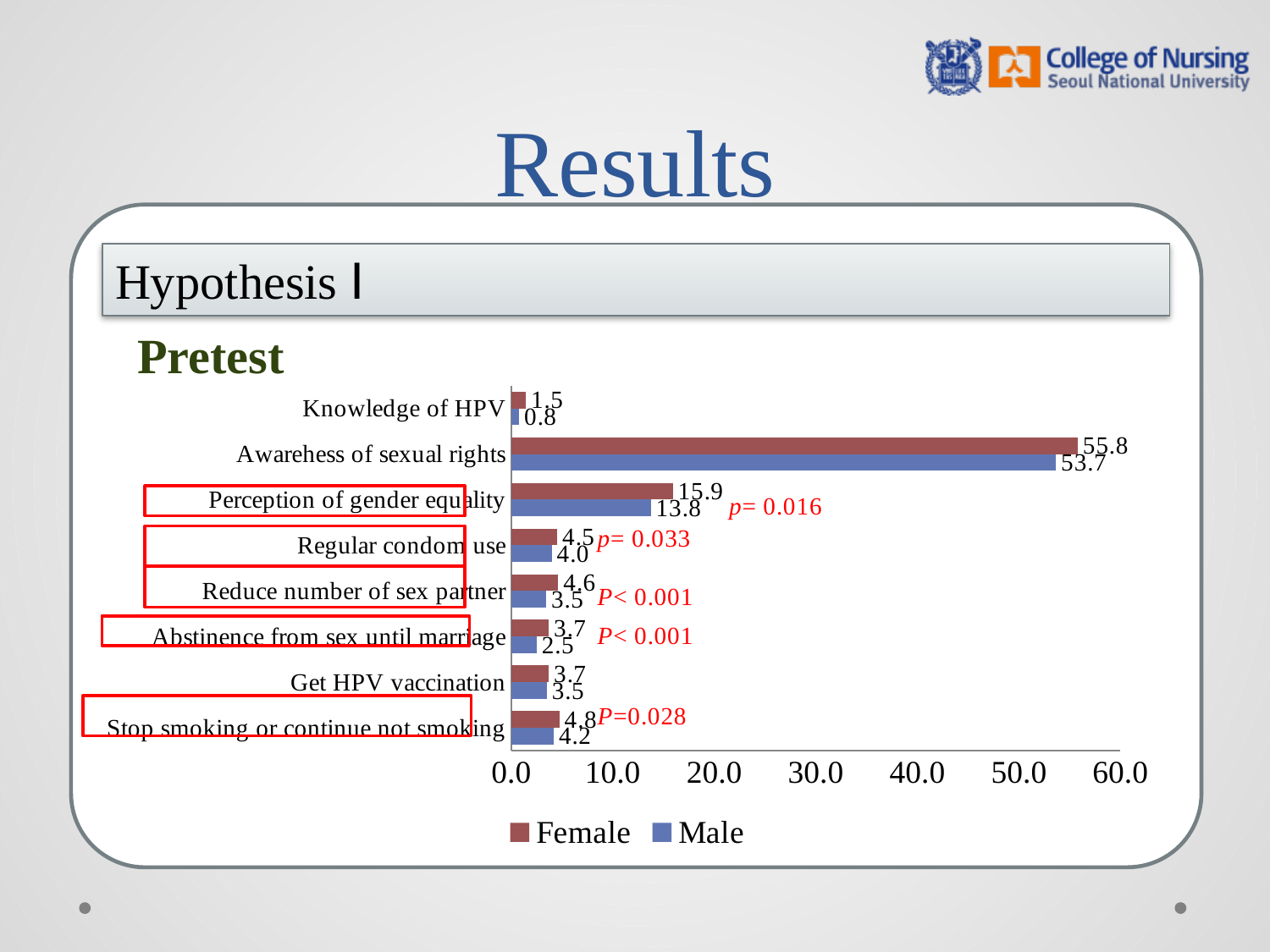
How many series does the legend list? 2 What kind of chart is shown on the slide? Bar chart Which is larger for Reduce number of sex partner, the Female value or the Male value? Female What is the Male value for Perception of gender equality? 13.8 What is the difference between the Female and Male values for Abstinence from sex until marriage? 1.2 What is the Male value for Knowledge of HPV? 0.8 What is the difference between the Female and Male values for Awareness of sexual rights? 2.1 Which category has the highest Female value? Awareness of sexual rights What is the Female value for Awareness of sexual rights? 55.8 Which category has the lowest Male value? Knowledge of HPV How many categories are shown on the chart? 8 What is the Female value for Stop smoking or continue not smoking? 4.8